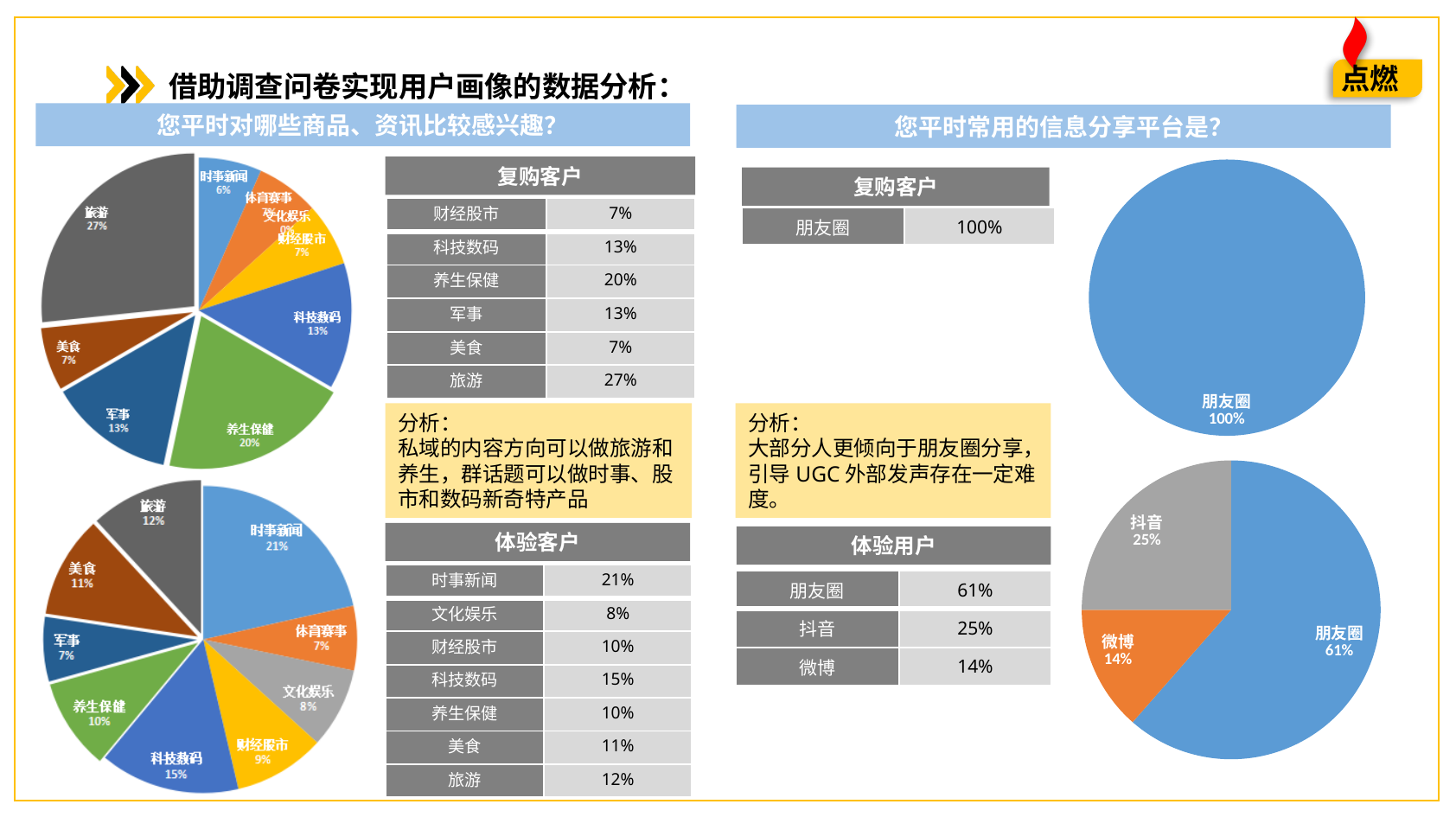
In the bottom-left pie chart (体验客户 interests), what is the difference between the 时事新闻 share and the 美食 share? 10% In the bottom-right pie chart (体验用户 sharing platforms), what share does 抖音 have? 25% What kind of chart is used in the top-left chart showing 复购客户 interests? Pie chart In the top-right pie chart (复购客户 sharing platforms), what share does 朋友圈 have? 100% In the bottom-left pie chart (体验客户 interests), which is larger, 科技数码 or 旅游? 科技数码 In the bottom-right pie chart (体验用户 sharing platforms), what share does 朋友圈 have? 61% In the bottom-right pie chart (体验用户 sharing platforms), how many slices are there? 3 In the top-left pie chart (复购客户 interests), which category has the largest slice? 旅游 In the bottom-right pie chart (体验用户 sharing platforms), which platform has the smallest slice? 微博 In the bottom-right pie chart, what is the difference between the 朋友圈 share and the 抖音 share? 36%